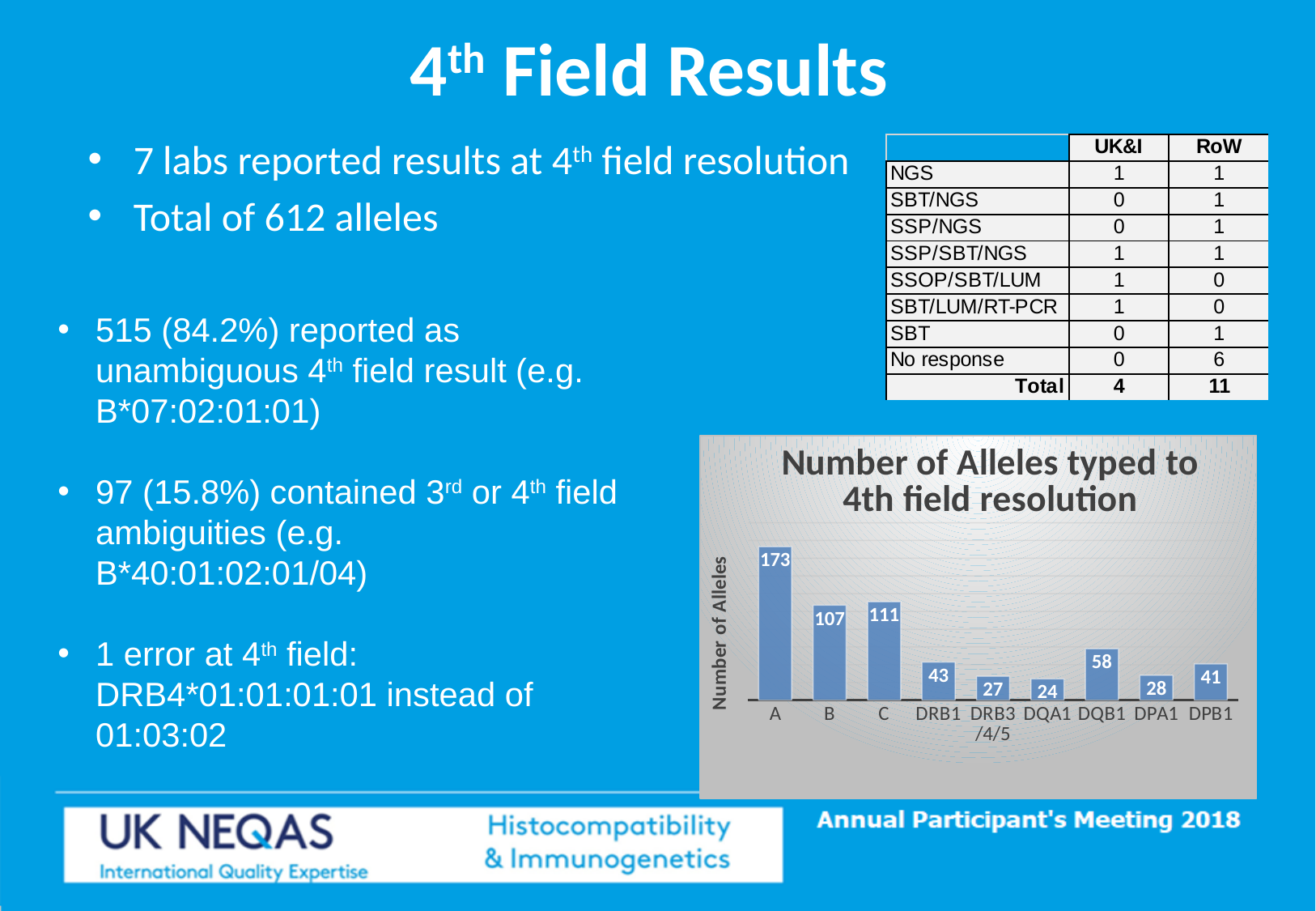
What is the difference between the values for DQB1 and DPB1? 17 What is the value shown for DQB1 in the chart? 58 Which locus has the lowest number of alleles typed to 4th field resolution? DQA1 What is the value shown for DRB3/4/5 in the chart? 27 What is the difference between the values for A and B in the chart? 66 Which locus has the highest number of alleles typed to 4th field resolution? A Which has a larger value in the chart, DRB1 or DPA1? DRB1 How many loci (categories) are shown on the x axis of the chart? 9 Which has a larger value in the chart, B or C? C What type of chart is used to show the number of alleles typed to 4th field resolution? Bar chart What is the number of alleles typed to 4th field resolution for locus A? 173 What is the title of the chart on the slide? Number of Alleles typed to 4th field resolution